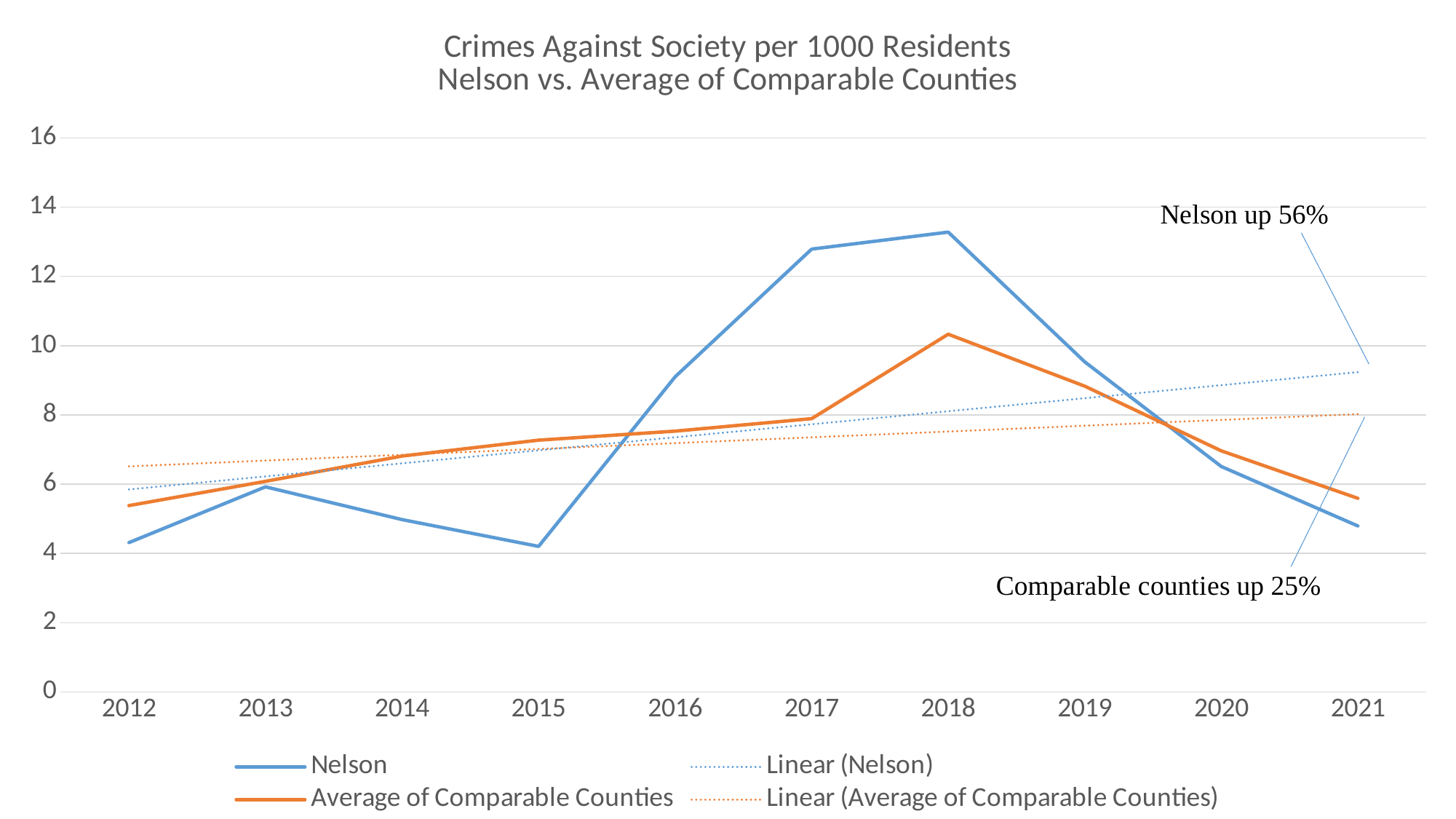
What kind of chart is shown on the slide? Line chart Is the value for Nelson in 2018 greater or less than 12? greater Is the value for Nelson in 2012 greater or less than 6? less In which year does the Average of Comparable Counties line reach its highest value? 2018 According to the annotation on the chart, by what percentage is Nelson up? 56% How many years are plotted along the x axis? 10 In which year does the Nelson line reach its highest value? 2018 In 2015, which series has the higher value, Nelson or Average of Comparable Counties? Average of Comparable Counties Does the Nelson line rise or fall from 2018 to 2021? Fall In 2018, which series has the higher value, Nelson or Average of Comparable Counties? Nelson How many entries does the legend list? 4 Is the value for Average of Comparable Counties in 2018 greater or less than 8? greater